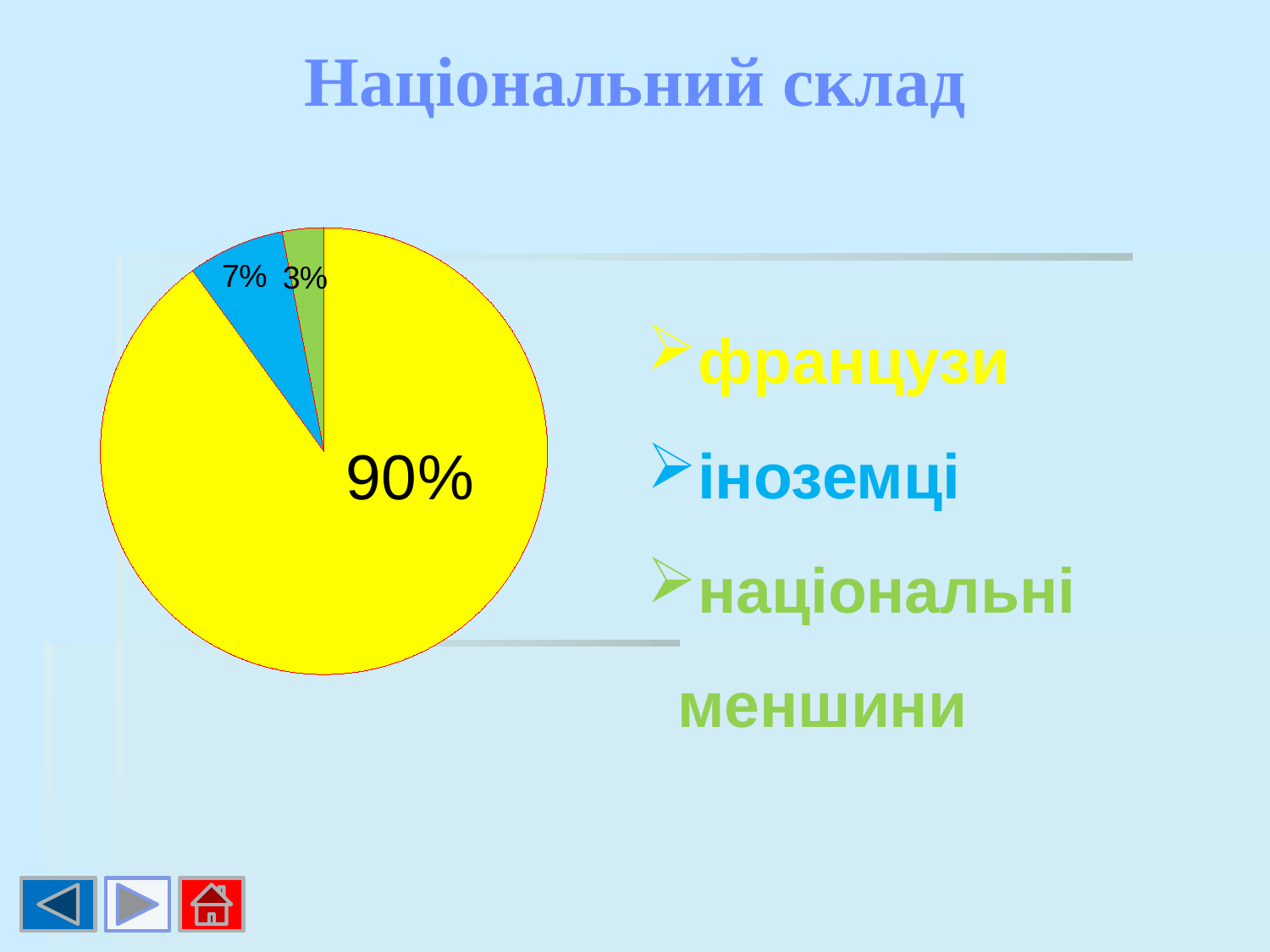
Which is larger, the slice for іноземці or the slice for національні меншини? іноземці Which category has the largest slice of the pie? французи What colour is the slice representing іноземці? blue What kind of chart is shown on the slide? pie chart Which category has the smallest slice of the pie? національні меншини What share of the pie does the blue slice (іноземці) represent? 7% What is the title of the chart on the slide? Національний склад What is the difference between the share for французи and the share for іноземці? 83% What is the difference between the share for іноземці and the share for національні меншини? 4% What share of the pie does the yellow slice (французи) represent? 90% How many slices does the pie chart have? 3 What share of the pie does the green slice (національні меншини) represent? 3%